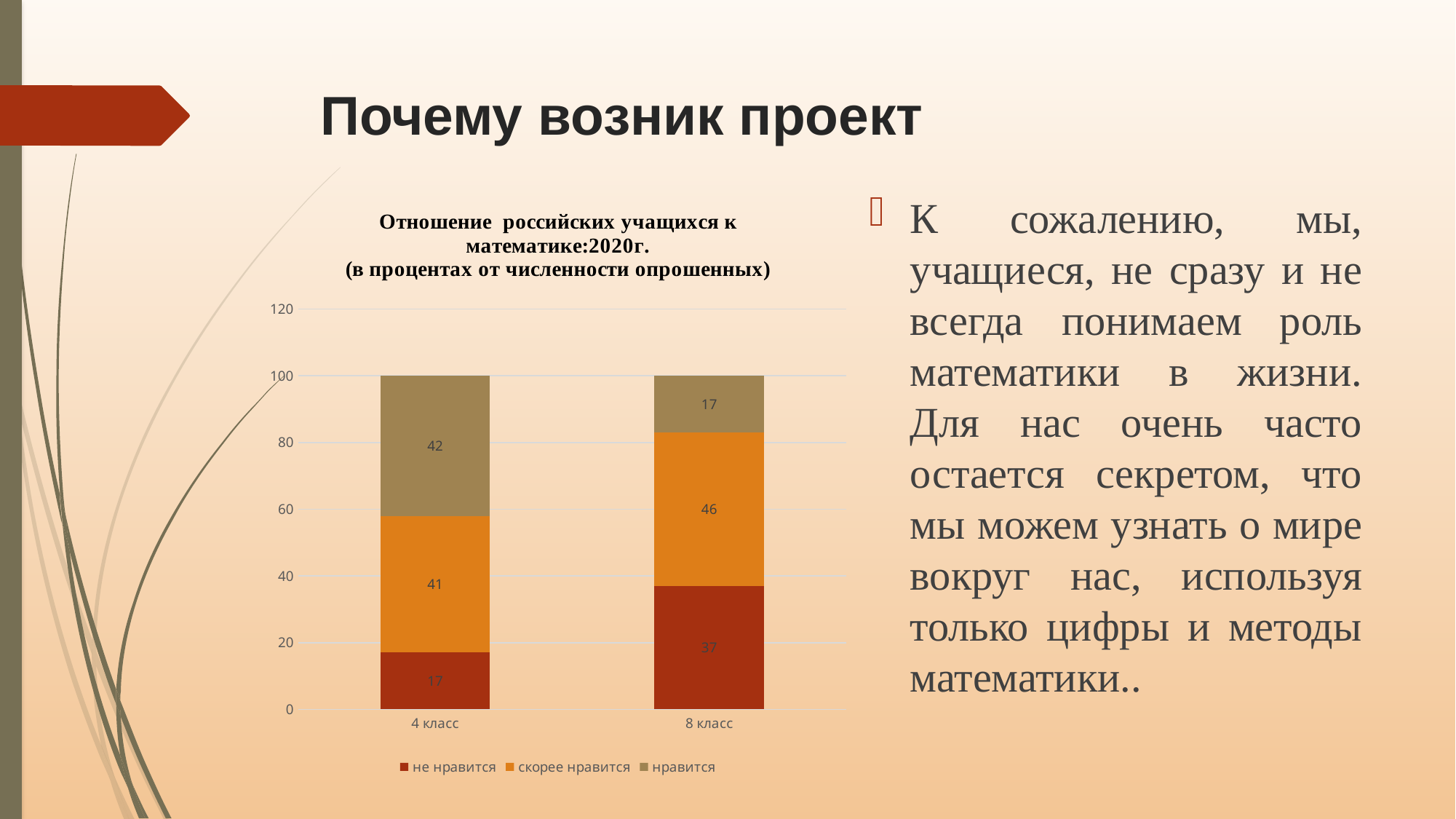
Which series has the lowest value for "8 класс"? нравится How many series does the legend list? 3 What is the difference between the "не нравится" values for "8 класс" and "4 класс"? 20 What is the total of the stacked bar for "8 класс"? 100 How many categories are shown on the x axis? 2 What is the value of "нравится" for "4 класс"? 42 What is the value of "не нравится" for "8 класс"? 37 What type of chart is shown on the slide? stacked bar chart What is the value of "не нравится" for "4 класс"? 17 What is the value of "скорее нравится" for "8 класс"? 46 Which category has the higher value for "нравится"? 4 класс What is the title of the chart? Отношение российских учащихся к математике:2020г. (в процентах от численности опрошенных)